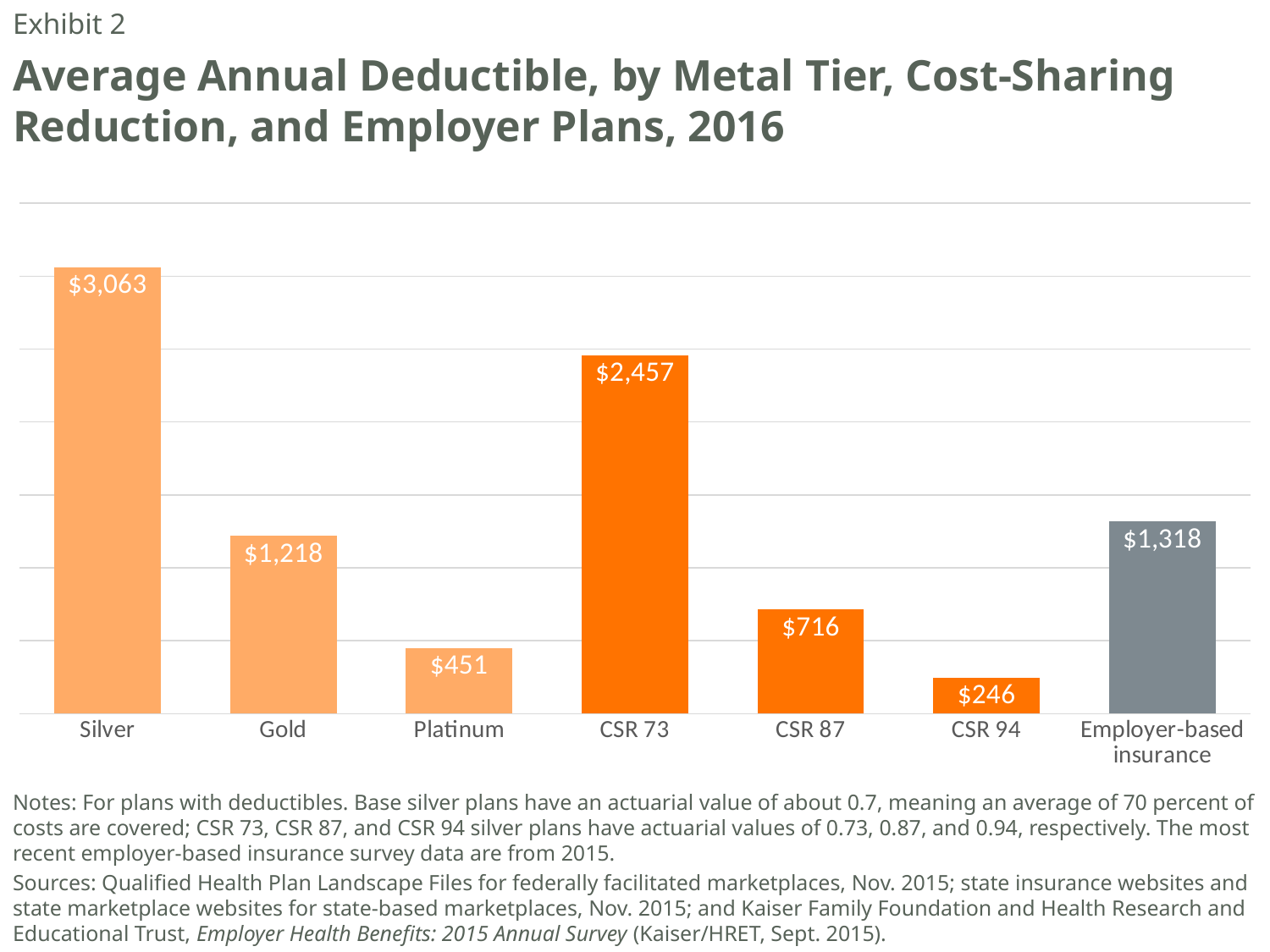
What is the difference between the Gold deductible and the Platinum deductible? $767 How many categories are shown on the chart? 7 Which category has the lowest average annual deductible? CSR 94 Which category has the highest average annual deductible? Silver What is the average annual deductible for CSR 94 plans? $246 What kind of chart is shown on the slide? Bar chart What is the average annual deductible for Employer-based insurance? $1,318 Which has a larger average annual deductible, Gold or Employer-based insurance? Employer-based insurance Which has a larger average annual deductible, CSR 87 or Platinum? CSR 87 What is the difference between the Silver deductible and the CSR 73 deductible? $606 Do the values fall or rise from CSR 73 to CSR 94 along the x axis? Fall What is the average annual deductible for Silver plans? $3,063